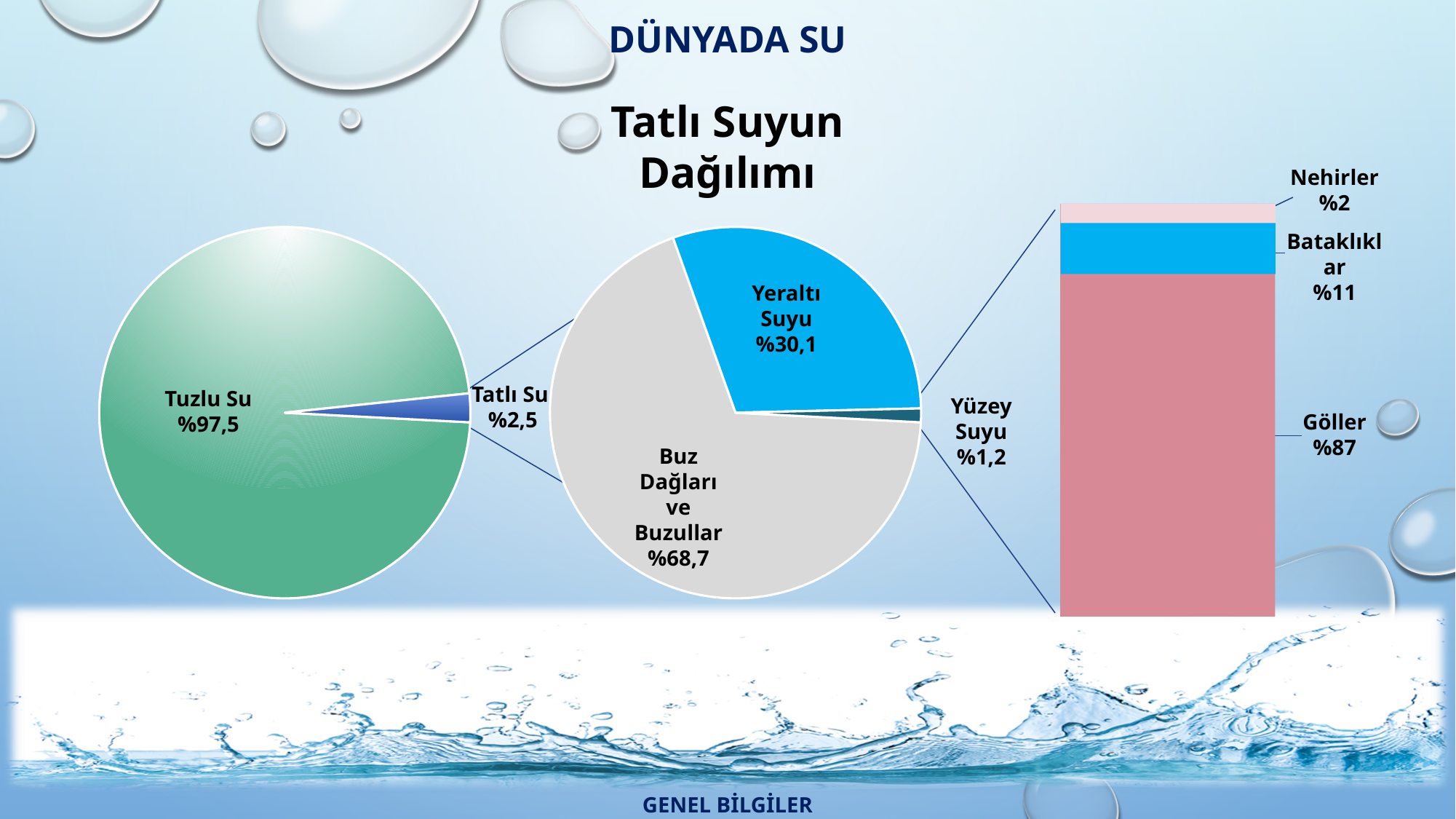
In the stacked bar chart on the right, what is the value for Göller? %87 In the stacked bar chart on the right, what is the value for Bataklıklar? %11 In the middle pie chart, which category has the smallest share? Yüzey Suyu In the middle pie chart, how many categories are shown? 3 What type of chart is the chart on the right of the slide? Stacked bar chart In the middle pie chart, what is the value for Yeraltı Suyu? %30,1 In the middle pie chart, what is the difference between Buz Dağları ve Buzullar and Yeraltı Suyu? %38,6 In the left pie chart, what is the value for Tatlı Su? %2,5 In the middle pie chart, what is the value for Yüzey Suyu? %1,2 In the middle pie chart, which category has the largest share? Buz Dağları ve Buzullar In the left pie chart, what is the value for Tuzlu Su? %97,5 In the stacked bar chart on the right, which is larger, Nehirler or Bataklıklar? Bataklıklar